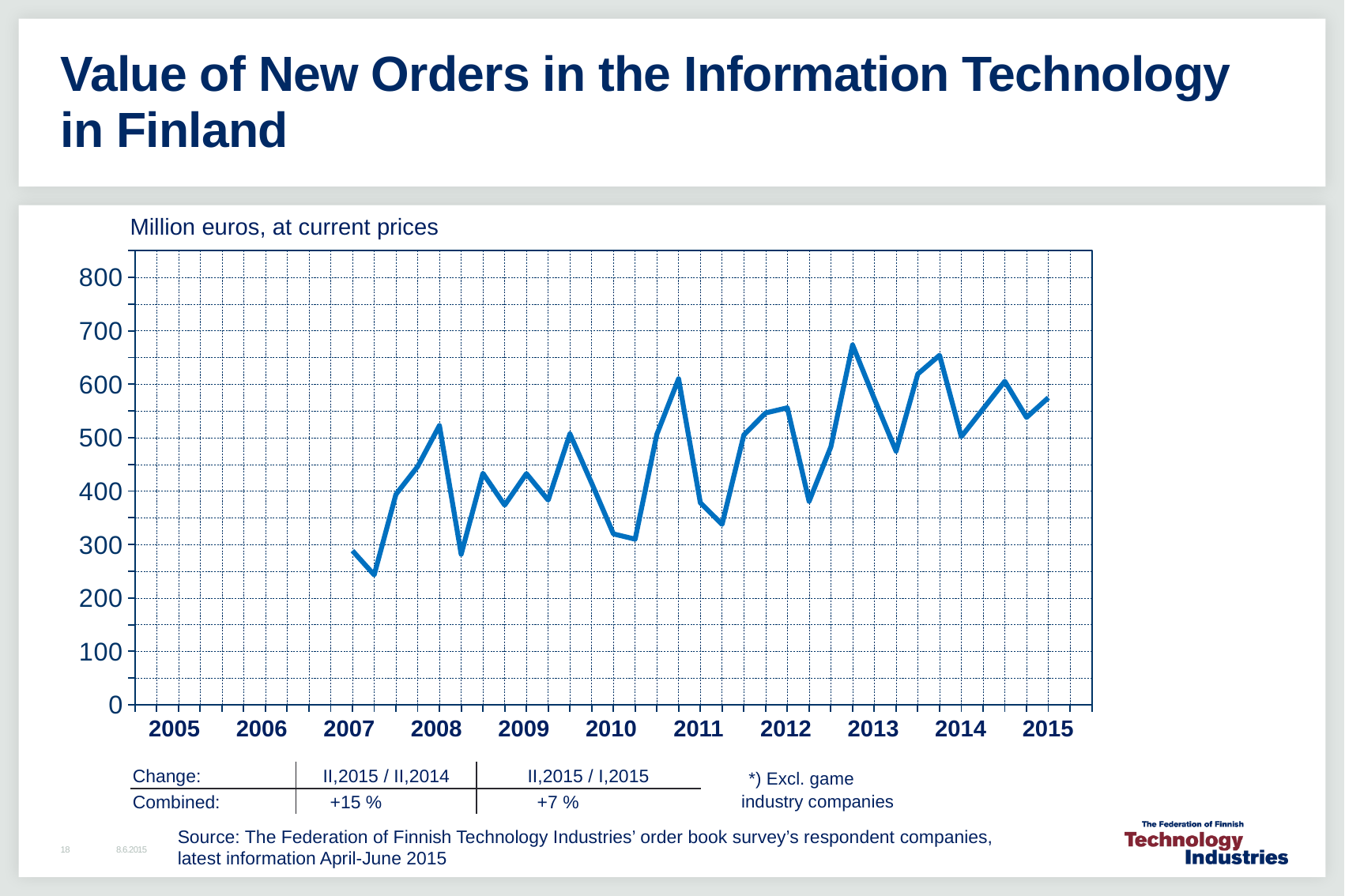
Which is larger: the value at the first point of the line in 2007 or the value at the last point in 2015? 2015 How many year labels are shown along the x axis? 11 What is the title of the chart on the slide? Value of New Orders in the Information Technology in Finland What kind of chart is shown on the slide? line chart Is the value at the low point in mid-2011 greater or less than 400? less Is the value at the start of 2012 greater or less than 500? greater Is the highest peak of the line, reached around the end of 2012, greater or less than 700? less How many data series are plotted on the chart? 1 In what unit are the values on the chart expressed, according to the label above the plot? Million euros, at current prices Overall, do the values rise or fall from the start of the line in 2007 to the end in 2015? rise